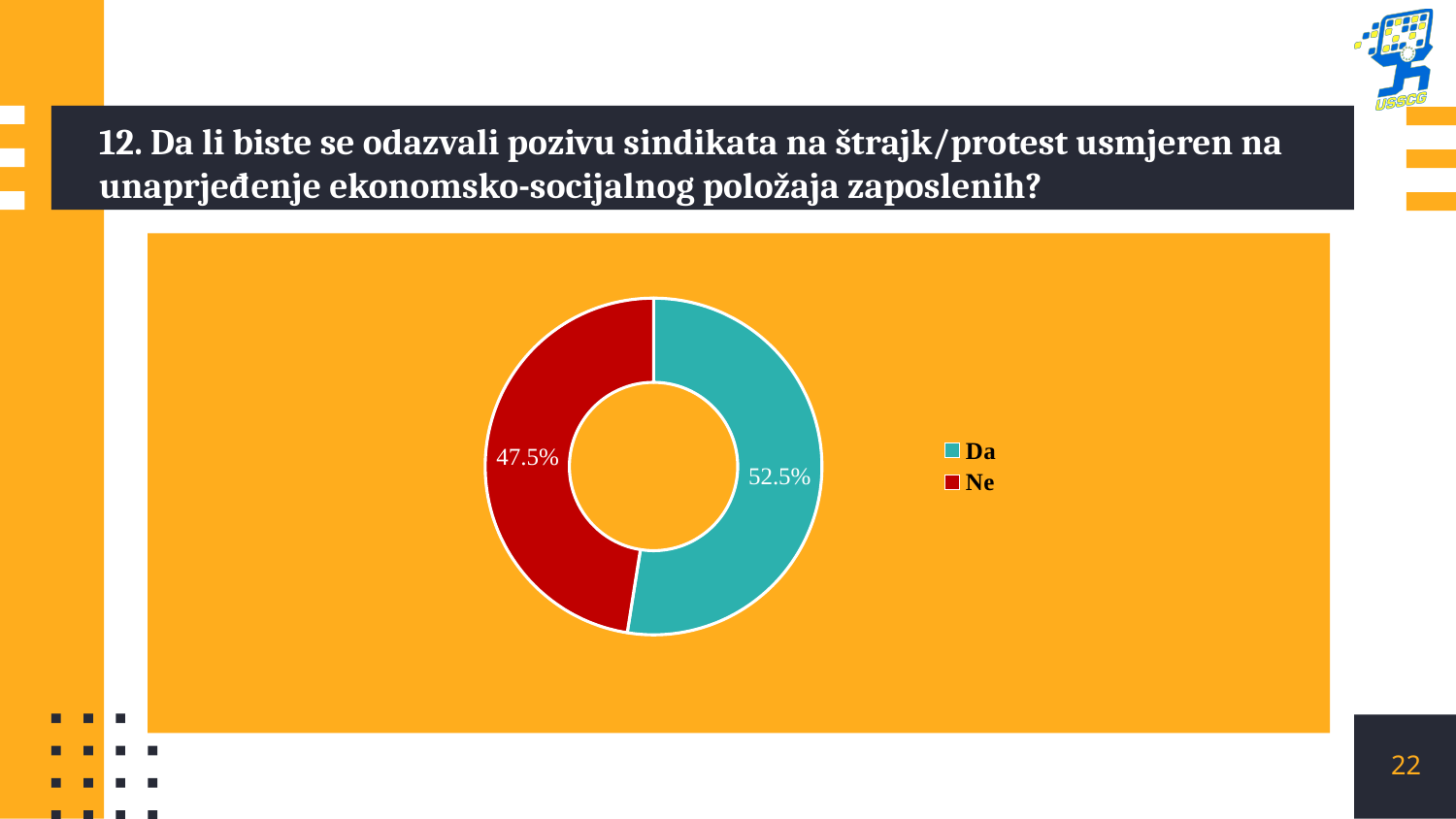
What percentage of respondents answered "Da"? 52.5% Which category has the smallest share of the chart? Ne Is the share for "Da" greater or less than 50%? greater What percentage of respondents answered "Ne"? 47.5% What is the difference in percentage points between the "Da" and "Ne" shares? 5 percentage points What are the two legend entries of the chart? Da and Ne What type of chart is shown on the slide? Doughnut (pie) chart How many categories does the chart show? 2 What colour represents "Ne" in the chart? Red Is the share for "Ne" greater or less than 50%? less Which category has the largest share of the chart? Da Which response has the larger share, "Da" or "Ne"? Da